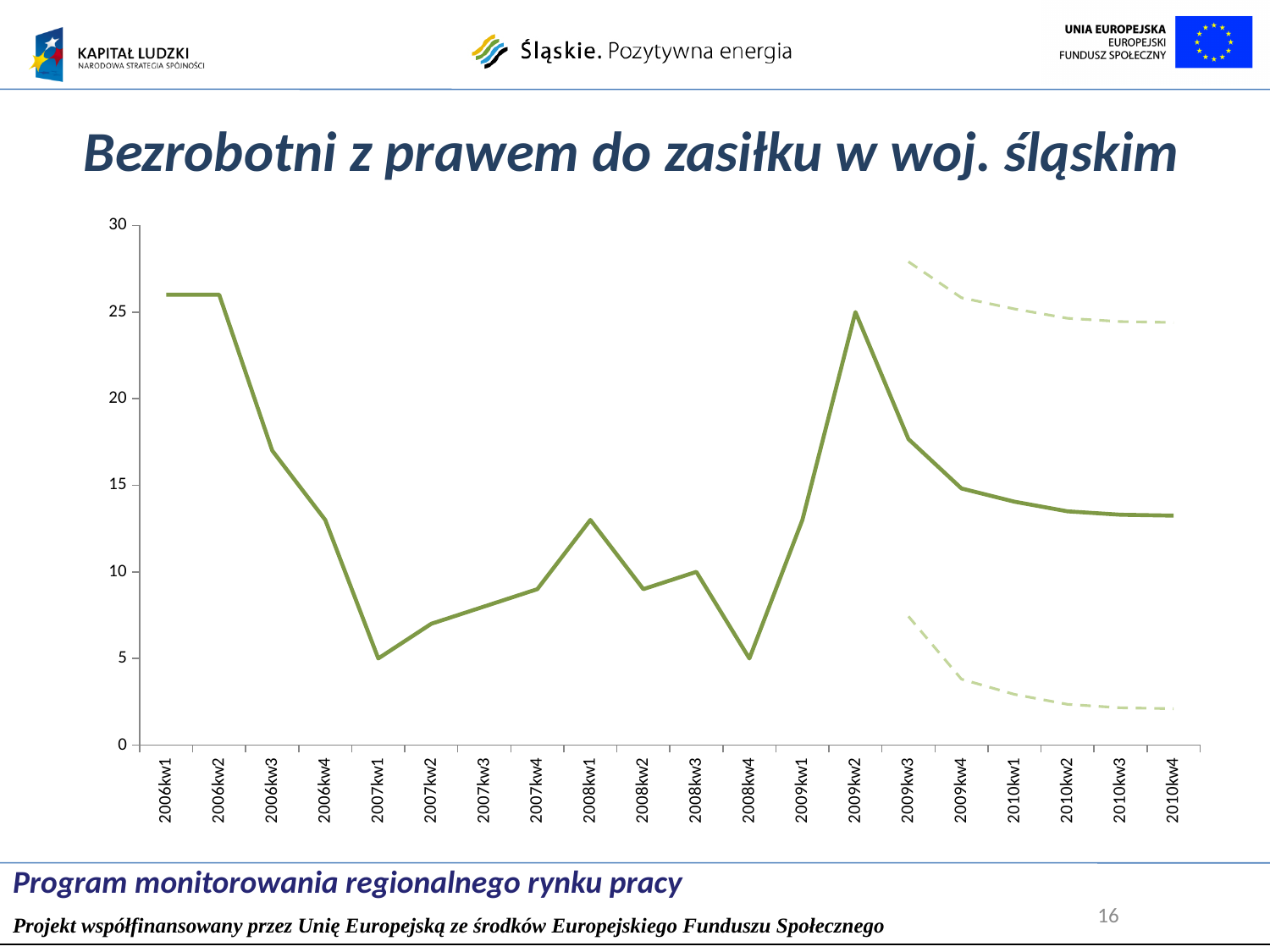
Is the value for 2007kw1 greater or less than 10? less Which is larger, the value for 2006kw1 or the value for 2007kw1? 2006kw1 Is the value for 2006kw3 greater or less than 15? greater Is the value for 2008kw4 greater or less than 10? less What is the title of the chart? Bezrobotni z prawem do zasiłku w woj. śląskim What kind of chart is shown on the slide? line chart Does the solid line rise or fall from 2006kw1 to 2007kw1? fall How many quarters (categories) are shown on the x axis? 20 Which is larger, the value for 2009kw2 or the value for 2008kw4? 2009kw2